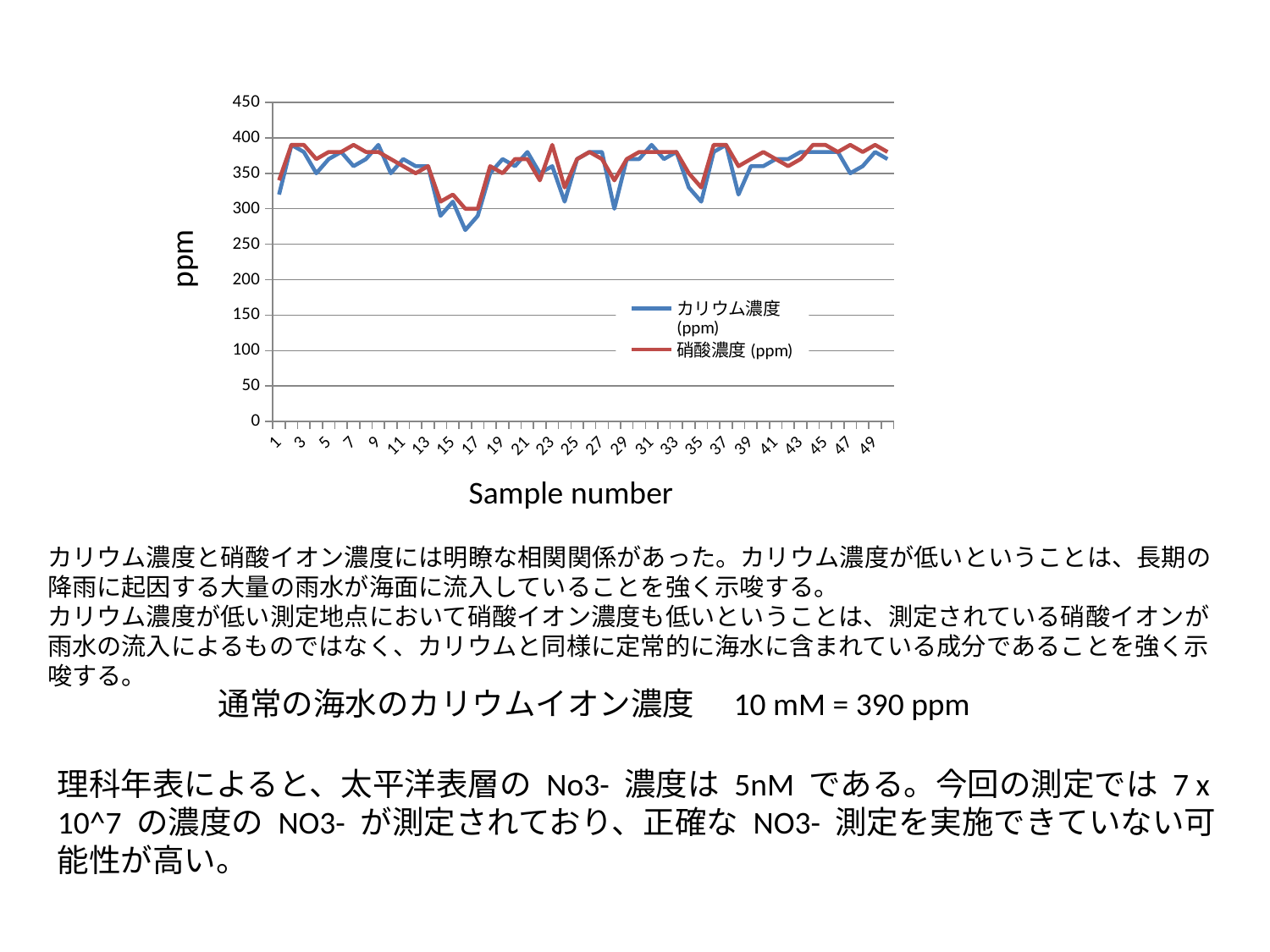
What is the title of the x axis of the chart? Sample number Is the 硝酸濃度 (ppm) value at sample 1 greater or less than 300? greater How many series does the chart's legend list? 2 What kind of chart is shown on the slide? line chart Is the カリウム濃度 (ppm) value at sample 24 greater or less than 350? less Is the カリウム濃度 (ppm) value at sample 3 greater or less than 350? greater What are the two series named in the chart's legend? カリウム濃度 (ppm) and 硝酸濃度 (ppm) What is the highest value shown on the y axis of the chart? 450 At which sample number does the カリウム濃度 (ppm) series reach its lowest value? 16